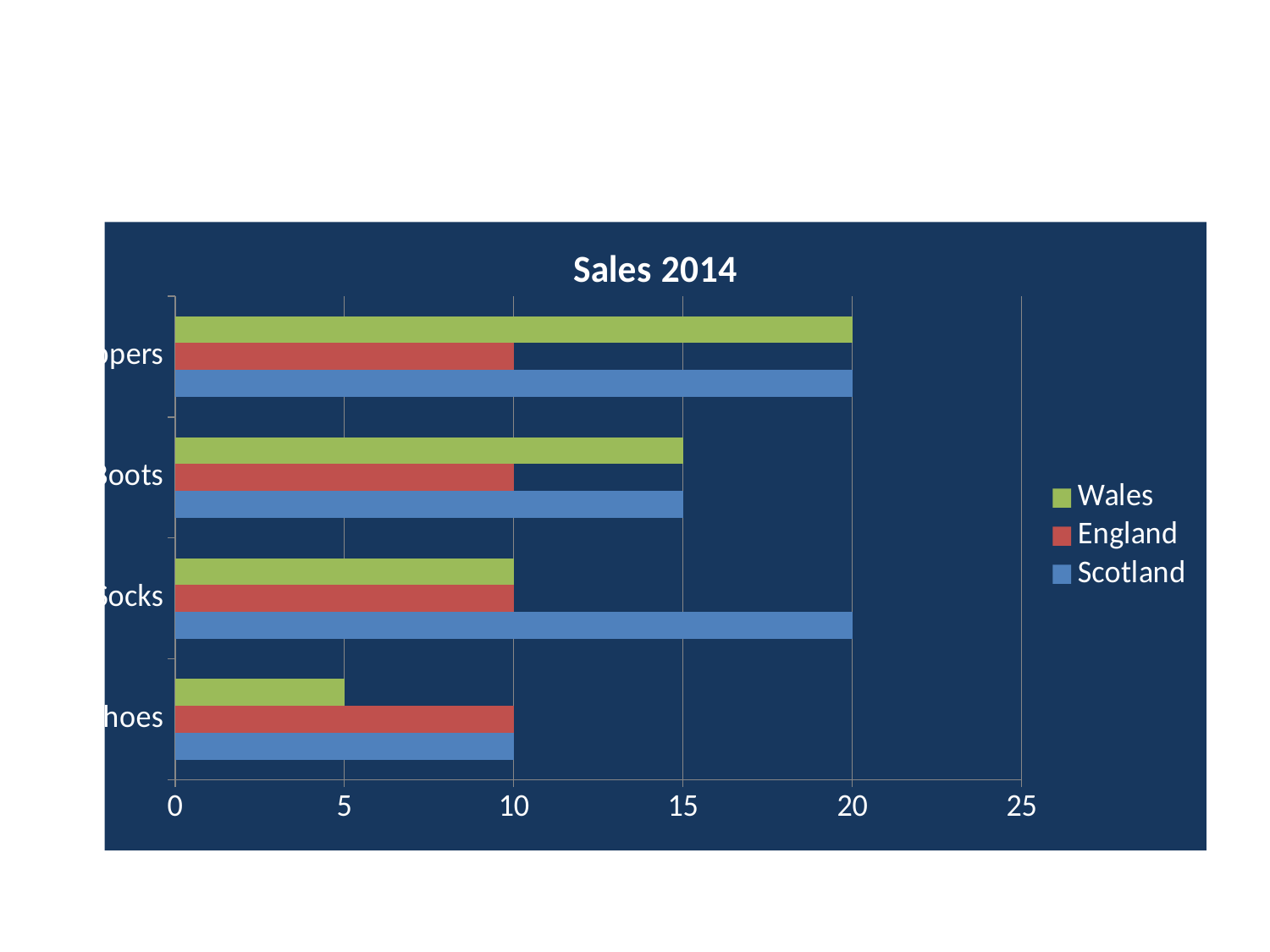
What kind of chart is shown on the slide? bar chart Which series has the lowest value in the bottom category of the chart? Wales What is the value for Wales in the Boots category? 15 What is the value for Scotland in the Socks category? 20 In the Boots category, is the value for Wales or England larger? Wales Which series has the highest value in the Socks category? Scotland What is the value for England in the Boots category? 10 How many series does the legend list? 3 What is the value for Wales in the bottom category of the chart? 5 What is the difference between the Scotland and England values in the Socks category? 10 How many categories are plotted on the chart? 4 What is the title of the chart? Sales 2014